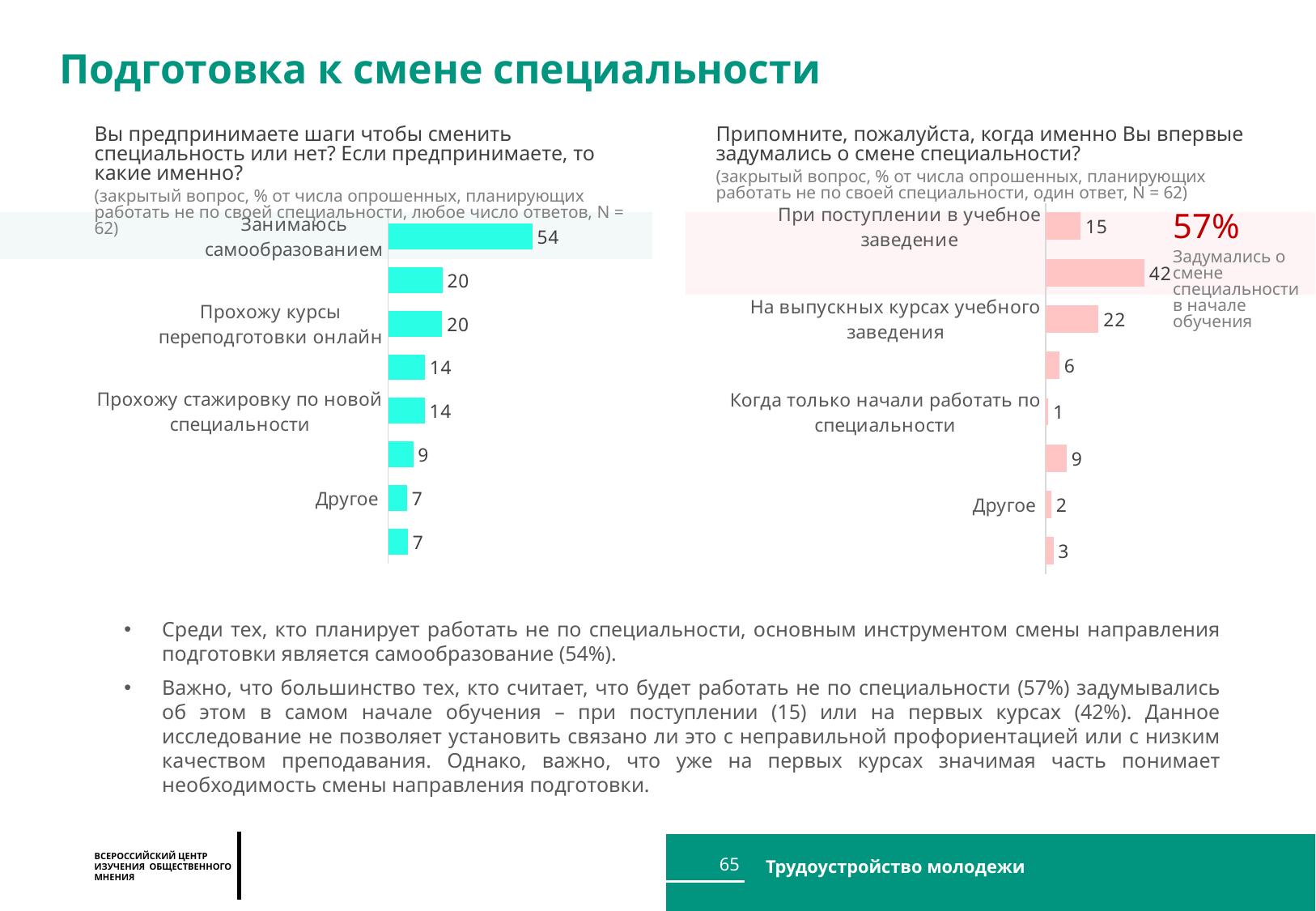
On the left chart, what is the difference between «Занимаюсь самообразованием» and «Прохожу курсы переподготовки онлайн»? 34 On the right chart, what is the value for «Когда только начали работать по специальности»? 1 On the right chart, what is the value for «При поступлении в учебное заведение»? 15 On the right chart, which is larger: «При поступлении в учебное заведение» or «На выпускных курсах учебного заведения»? На выпускных курсах учебного заведения On the right chart, what is the highest value shown? 42 What type of chart is the left chart? Bar chart On the left chart, what is the value for «Прохожу стажировку по новой специальности»? 14 How many bars does the right chart have? 8 On the left chart, what is the value for «Прохожу курсы переподготовки онлайн»? 20 On the left chart, which category has the highest value? Занимаюсь самообразованием On the left chart, what is the value for «Занимаюсь самообразованием»? 54 On the right chart, what is the value for «На выпускных курсах учебного заведения»? 22